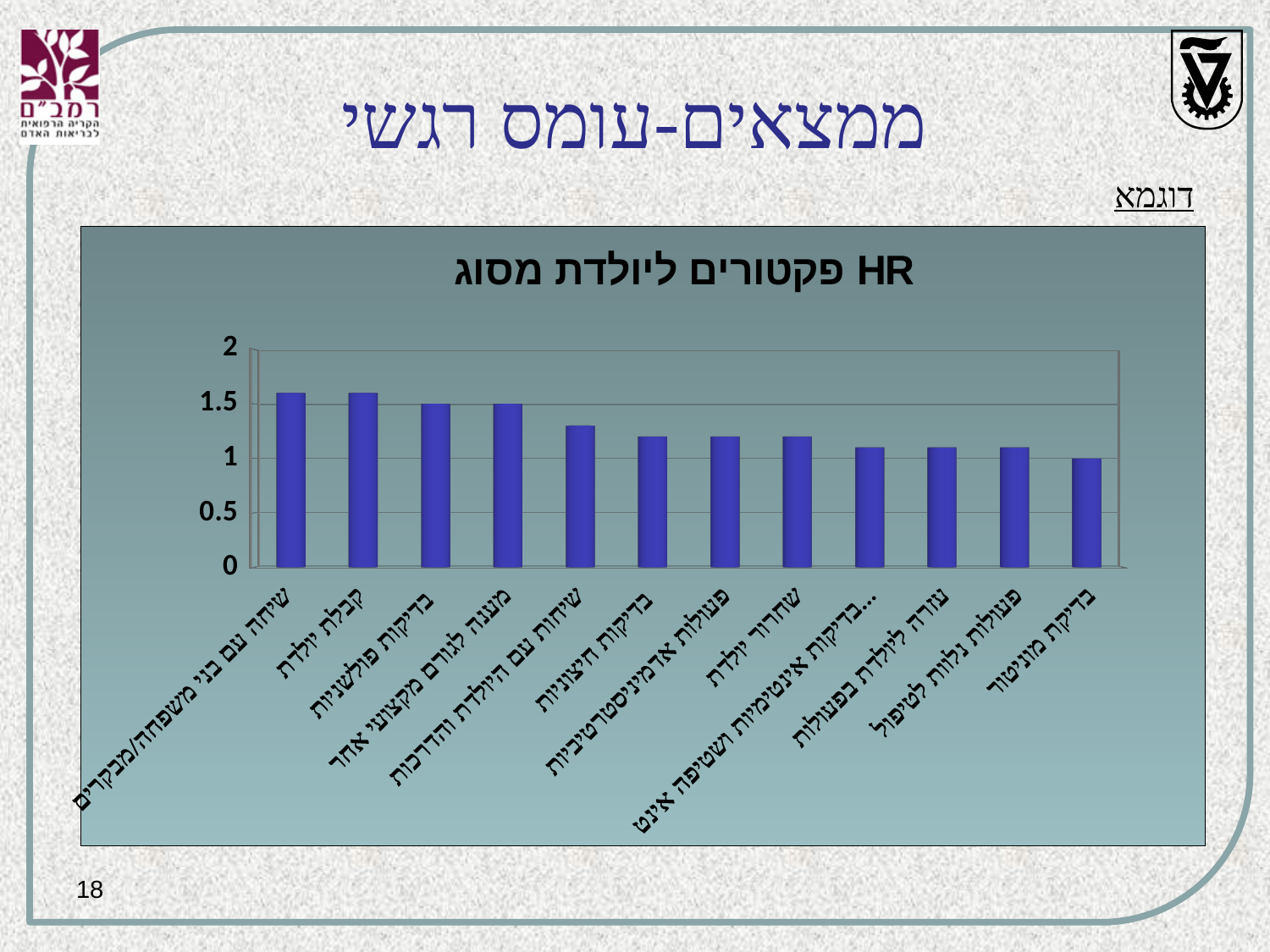
How many bars (categories) does the chart show? 12 What kind of chart is shown on the slide? bar chart What colour are the bars in the chart? blue Which category has the lowest bar in the chart? בדיקת מוניטור Is the value for בדיקות חיצוניות greater or less than 1? greater Do the bar values rise or fall from left to right along the x axis? fall Is the value for בדיקת מוניטור greater or less than 1.5? less Is the value for שיחה עם בני משפחה/מבקרים greater or less than 1? greater What is the title of the chart? HR פקטורים ליולדת מסוג Which is larger, the value for שיחה עם בני משפחה/מבקרים or the value for בדיקת מוניטור? שיחה עם בני משפחה/מבקרים Which is larger, the value for קבלת יולדת or the value for שחרור יולדת? קבלת יולדת